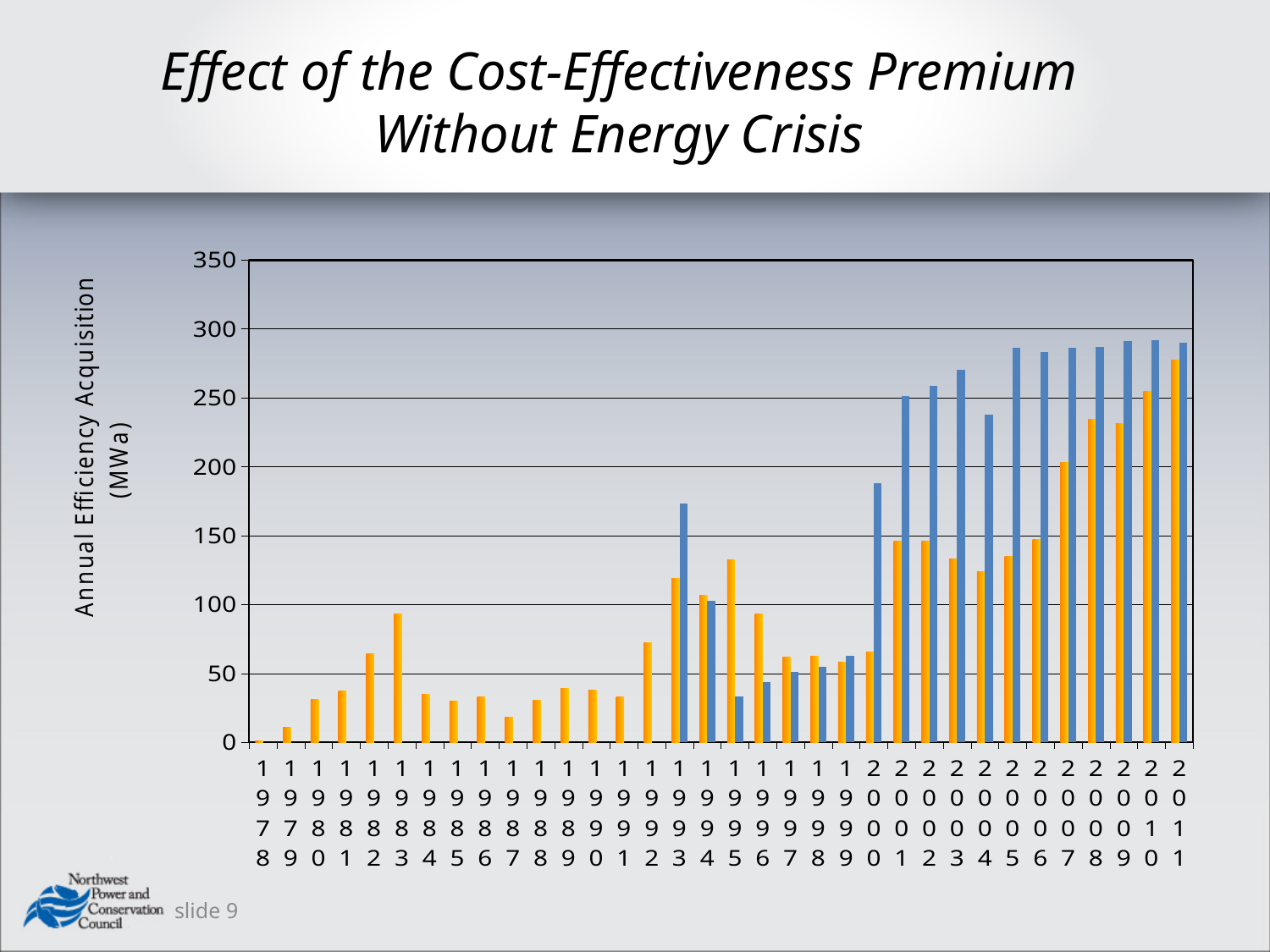
Is the value of the blue bar for 1995 greater or less than 50? less How many years are shown along the x axis of the chart? 34 Is the value of the orange bar for 2011 greater or less than 250? greater Is the value of the orange bar for 1983 greater or less than 100? less What kind of chart is shown on the slide? bar chart What is the title of the chart on the slide? Effect of the Cost-Effectiveness Premium Without Energy Crisis What is the label on the vertical axis of the chart? Annual Efficiency Acquisition (MWa) In which year is the blue bar the shortest? 1995 In which year is the orange bar the tallest? 2011 For 1993, which bar is taller, the blue bar or the orange bar? blue